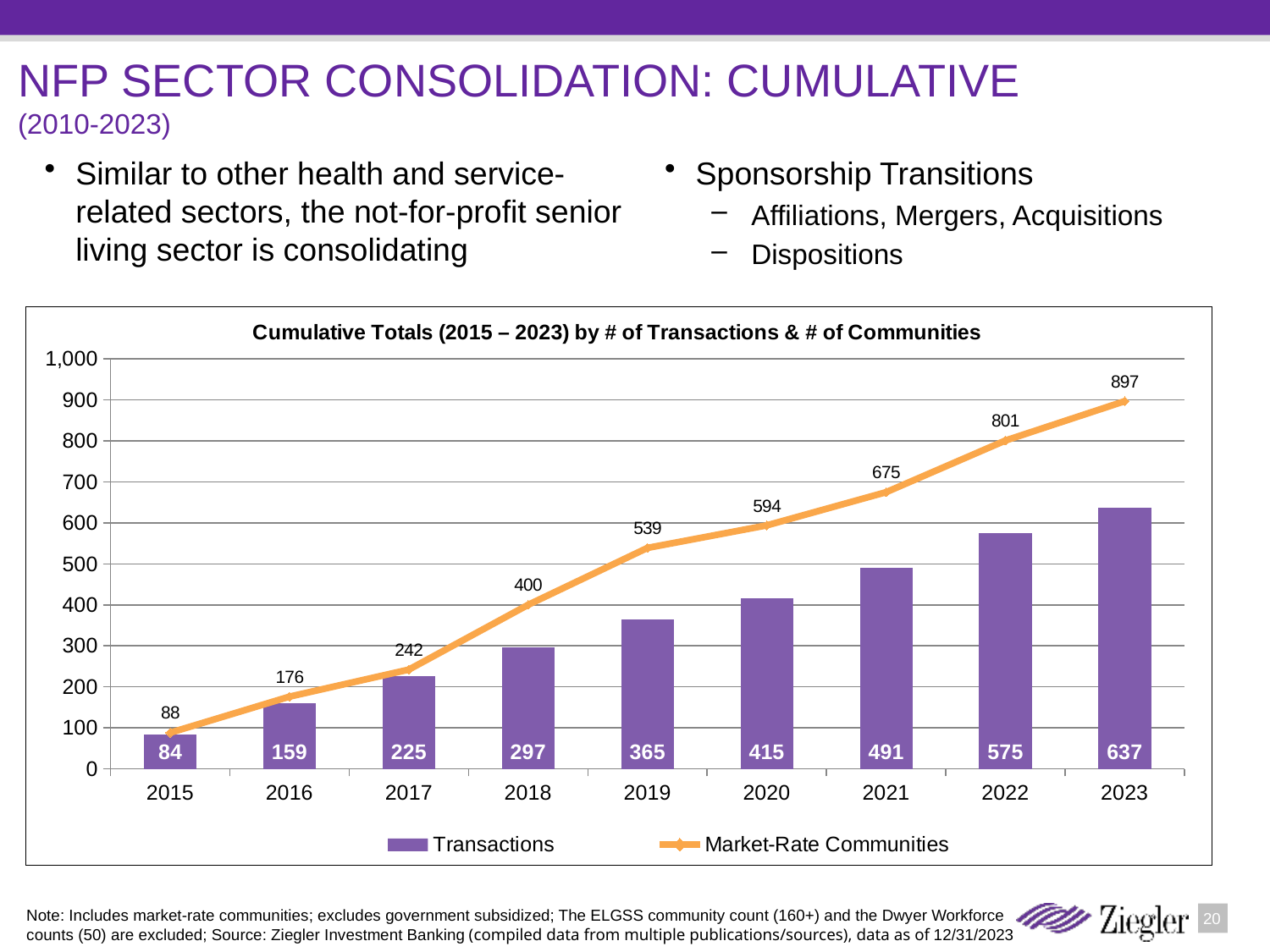
Is the number of Transactions in 2022 greater or less than 500? greater What kind of chart is used to show the Transactions series? Bar chart Which year has the lowest number of Transactions? 2015 Which year has the highest number of Market-Rate Communities? 2023 What is the number of Transactions in 2019? 365 How many years are shown on the x axis of the chart? 9 What is the number of Market-Rate Communities in 2021? 675 Do the Market-Rate Communities values rise or fall from 2015 to 2023? Rise Which is larger in 2018: the number of Transactions or the number of Market-Rate Communities? Market-Rate Communities What is the difference between the number of Market-Rate Communities in 2023 and in 2022? 96 How many series does the chart legend list? 2 What is the difference between the number of Transactions in 2020 and in 2015? 331